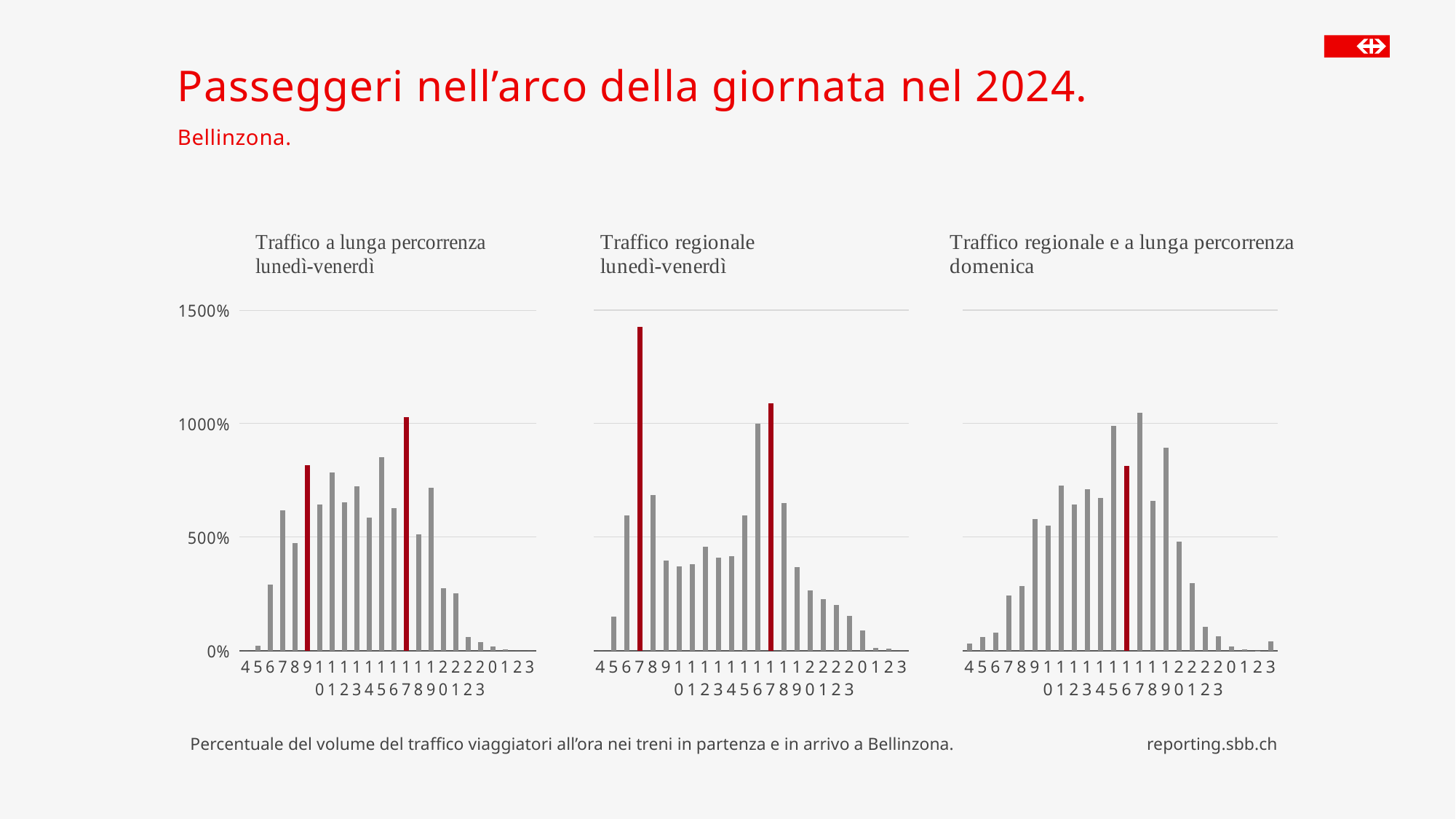
In the 'Traffico regionale lunedì-venerdì' chart, which hour has the highest value? 7 In the 'Traffico regionale lunedì-venerdì' chart, which is larger, the value for hour 7 or the value for hour 17? Hour 7 In the 'Traffico a lunga percorrenza lunedì-venerdì' chart, which hour has the highest value? 17 How many charts are shown on the slide? 3 In the 'Traffico regionale lunedì-venerdì' chart, do the values rise or fall from hour 17 to hour 23? Fall In the 'Traffico regionale lunedì-venerdì' chart, is the value for hour 10 greater or less than 500%? less In the 'Traffico regionale lunedì-venerdì' chart, how many hour categories are shown on the x axis? 24 In the 'Traffico regionale e a lunga percorrenza domenica' chart, which is larger, the value for hour 16 or the value for hour 17? Hour 17 In the 'Traffico regionale lunedì-venerdì' chart, is the value for hour 7 greater or less than 1000%? greater What kind of chart is used for 'Traffico a lunga percorrenza lunedì-venerdì'? Bar chart In the 'Traffico a lunga percorrenza lunedì-venerdì' chart, is the value for hour 9 greater or less than 500%? greater